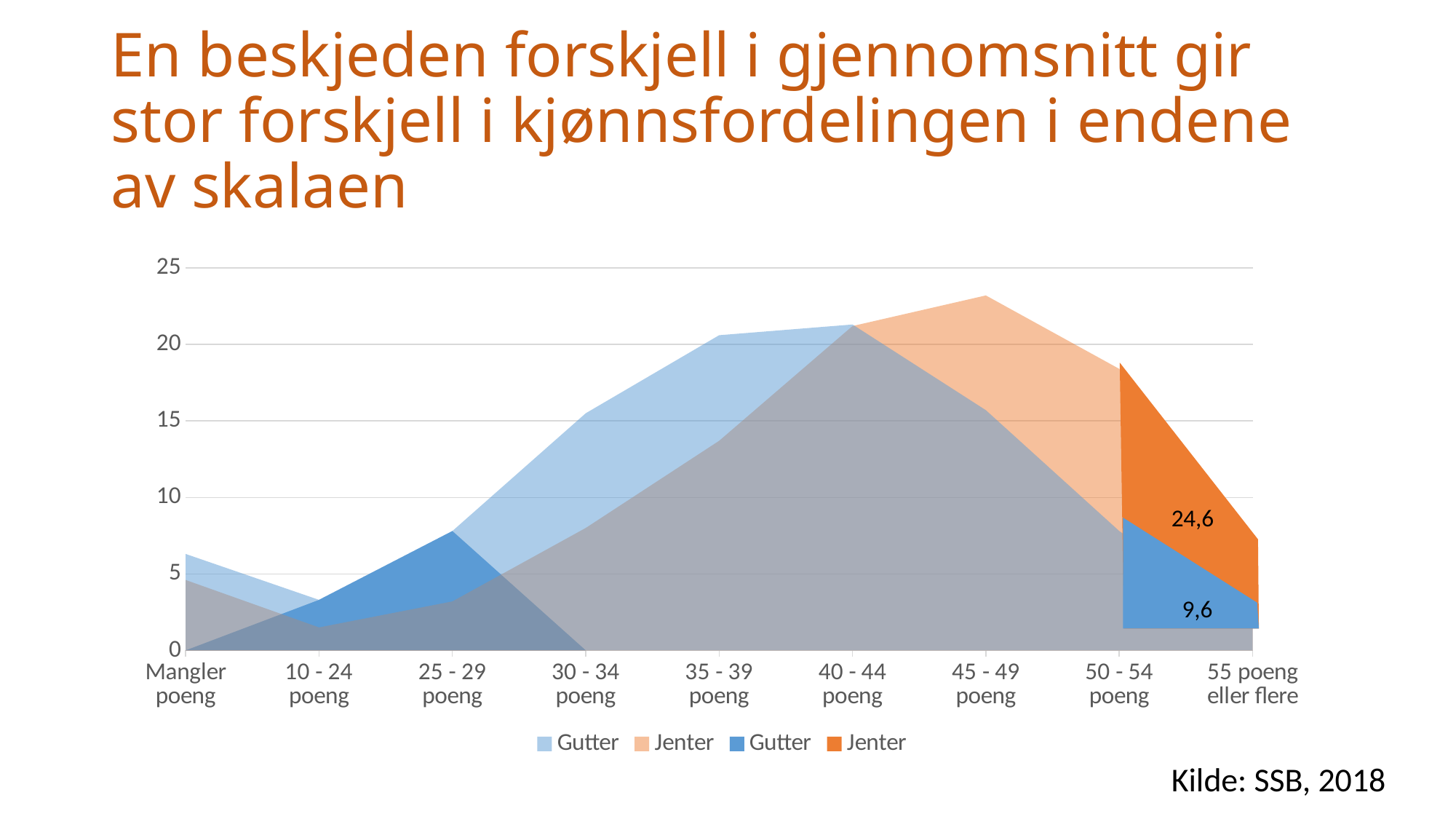
Is the value for Gutter at 50 - 54 poeng greater or less than 10? less Do the Jenter values rise or fall from 45 - 49 poeng to 55 poeng eller flere? fall Which category has the highest value for Jenter? 45 - 49 poeng At 35 - 39 poeng, which is larger, Gutter or Jenter? Gutter How many point categories are shown along the x axis? 9 Is the value for Jenter at 45 - 49 poeng greater or less than 20? greater What data label is printed on the dark orange Jenter area at the right end of the chart? 24,6 At 50 - 54 poeng, which is larger, Gutter or Jenter? Jenter How many series does the legend list? 4 What kind of chart is shown on the slide? area chart Is the value for Jenter at 30 - 34 poeng greater or less than 10? less Which category has the lowest value for Jenter? 10 - 24 poeng